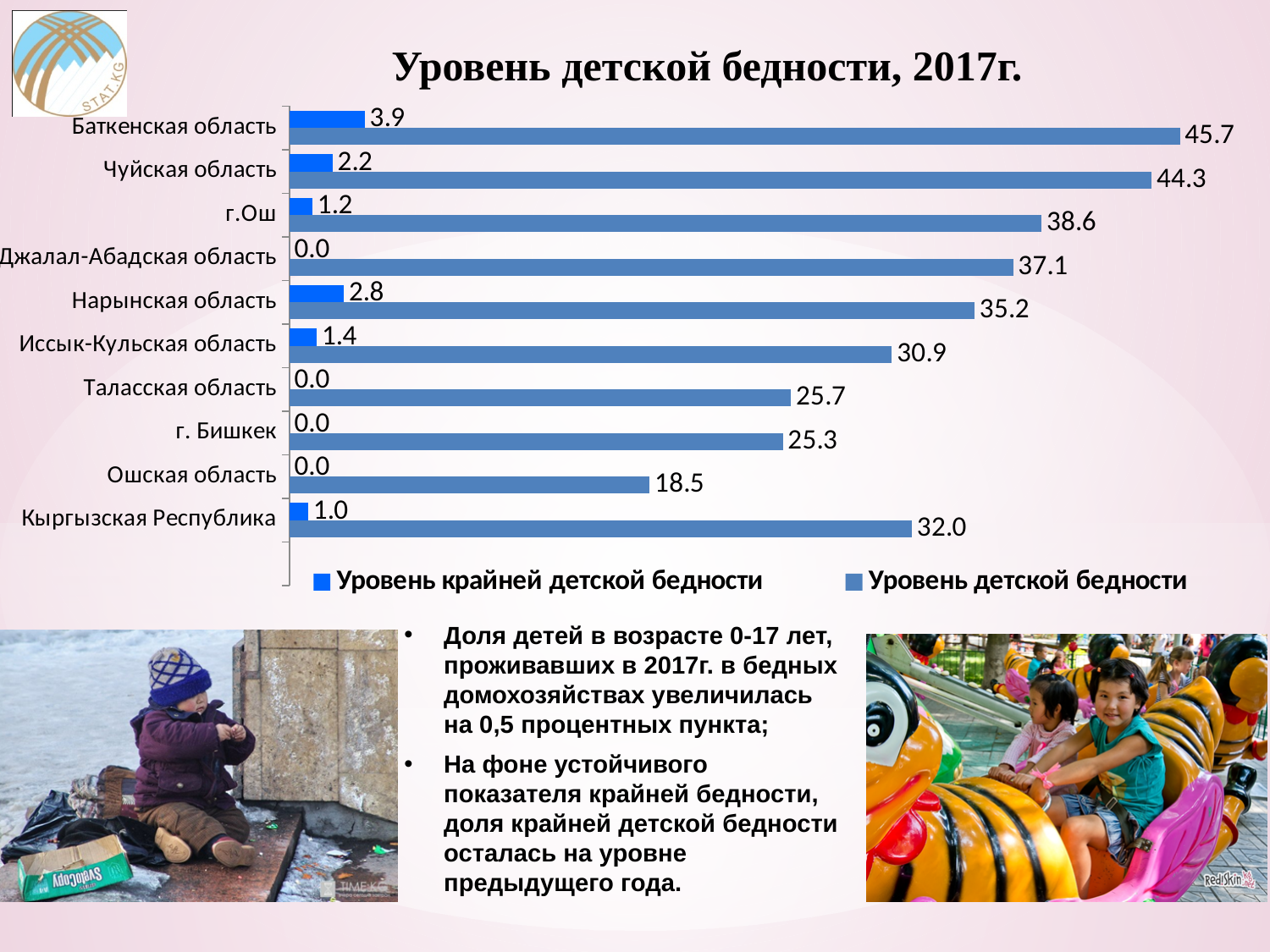
What is the difference between 'Уровень детской бедности' for Чуйская область and г.Ош? 5.7 Which category has the highest value of 'Уровень детской бедности'? Баткенская область Which is larger: 'Уровень детской бедности' for Таласская область or for г. Бишкек? Таласская область Which category has the lowest value of 'Уровень детской бедности'? Ошская область Which category has the highest value of 'Уровень крайней детской бедности'? Баткенская область How many categories are shown on the chart? 10 How many series does the legend list? 2 What is the value of 'Уровень детской бедности' for Баткенская область? 45.7 What kind of chart is shown on the slide? Bar chart What is the title of the chart? Уровень детской бедности, 2017г. What is the value of 'Уровень крайней детской бедности' for Нарынская область? 2.8 What is the value of 'Уровень детской бедности' for Кыргызская Республика? 32.0